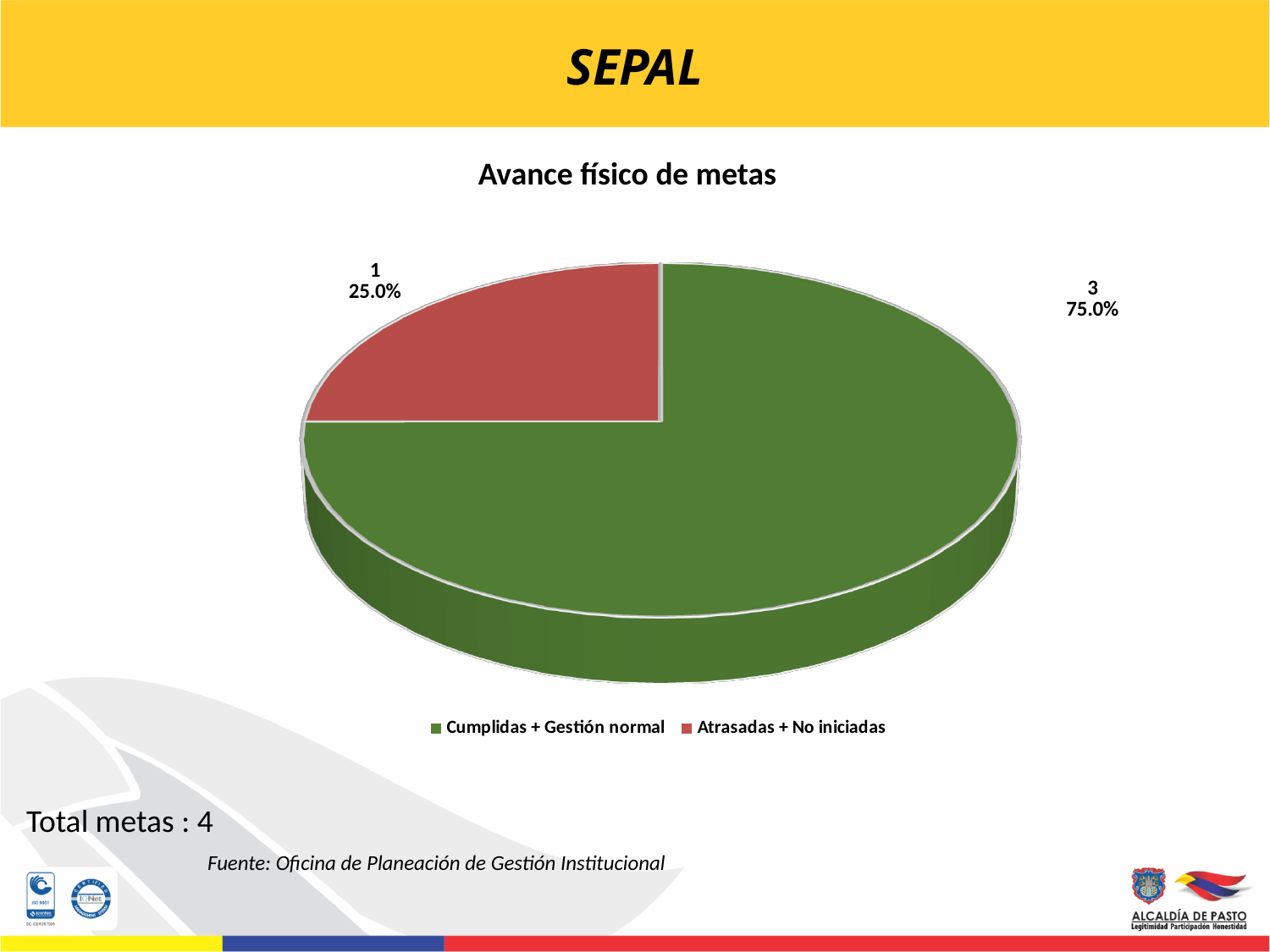
Which colour represents Atrasadas + No iniciadas in the chart? Red What is the difference between the values for Cumplidas + Gestión normal and Atrasadas + No iniciadas? 2 What share of the pie does Atrasadas + No iniciadas represent? 25.0% Which category has the smallest slice? Atrasadas + No iniciadas How many slices does the pie chart have? 2 How many entries does the legend list? 2 What is the title of the chart? Avance físico de metas What kind of chart is shown on the slide? Pie chart What share of the pie does Cumplidas + Gestión normal represent? 75.0% What is the value for Atrasadas + No iniciadas? 1 What is the value for Cumplidas + Gestión normal? 3 Which category has the largest slice? Cumplidas + Gestión normal